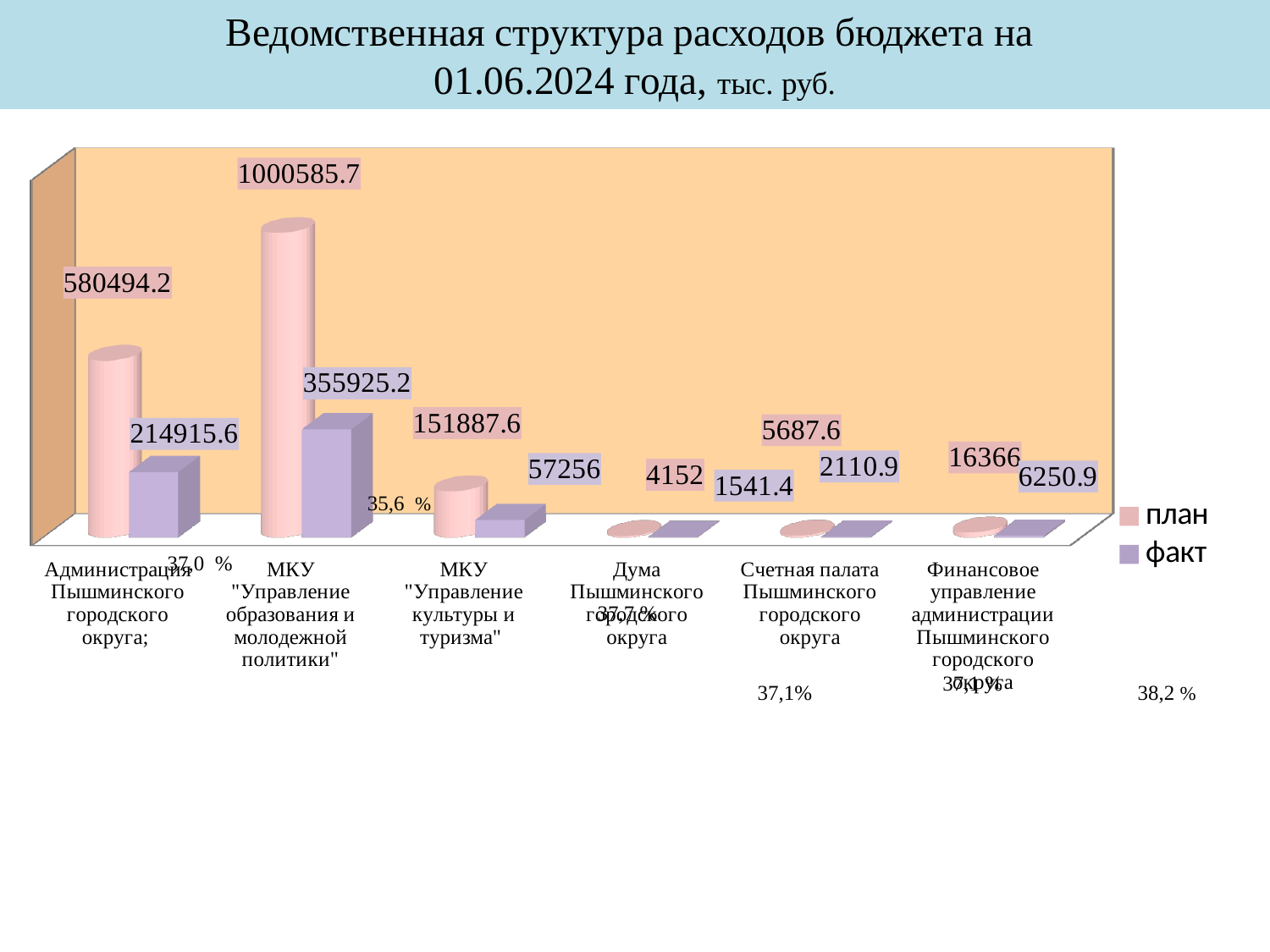
What is the факт value for Администрация Пышминского городского округа? 214915.6 What is the план value for МКУ "Управление образования и молодежной политики"? 1000585.7 Which category has the lowest факт value? Дума Пышминского городского округа What is the план value for Счетная палата Пышминского городского округа? 5687.6 What is the факт value for МКУ "Управление культуры и туризма"? 57256 Which is larger: the план value for Дума Пышминского городского округа or the план value for Счетная палата Пышминского городского округа? Счетная палата Пышминского городского округа What kind of chart is shown on the slide? bar chart How many categories are shown on the x axis? 6 What is the difference between the план and факт values for Финансовое управление администрации Пышминского городского округа? 10115.1 What is the difference between the план and факт values for Администрация Пышминского городского округа? 365578.6 Which category has the highest план value? МКУ "Управление образования и молодежной политики" How many series does the legend list? 2